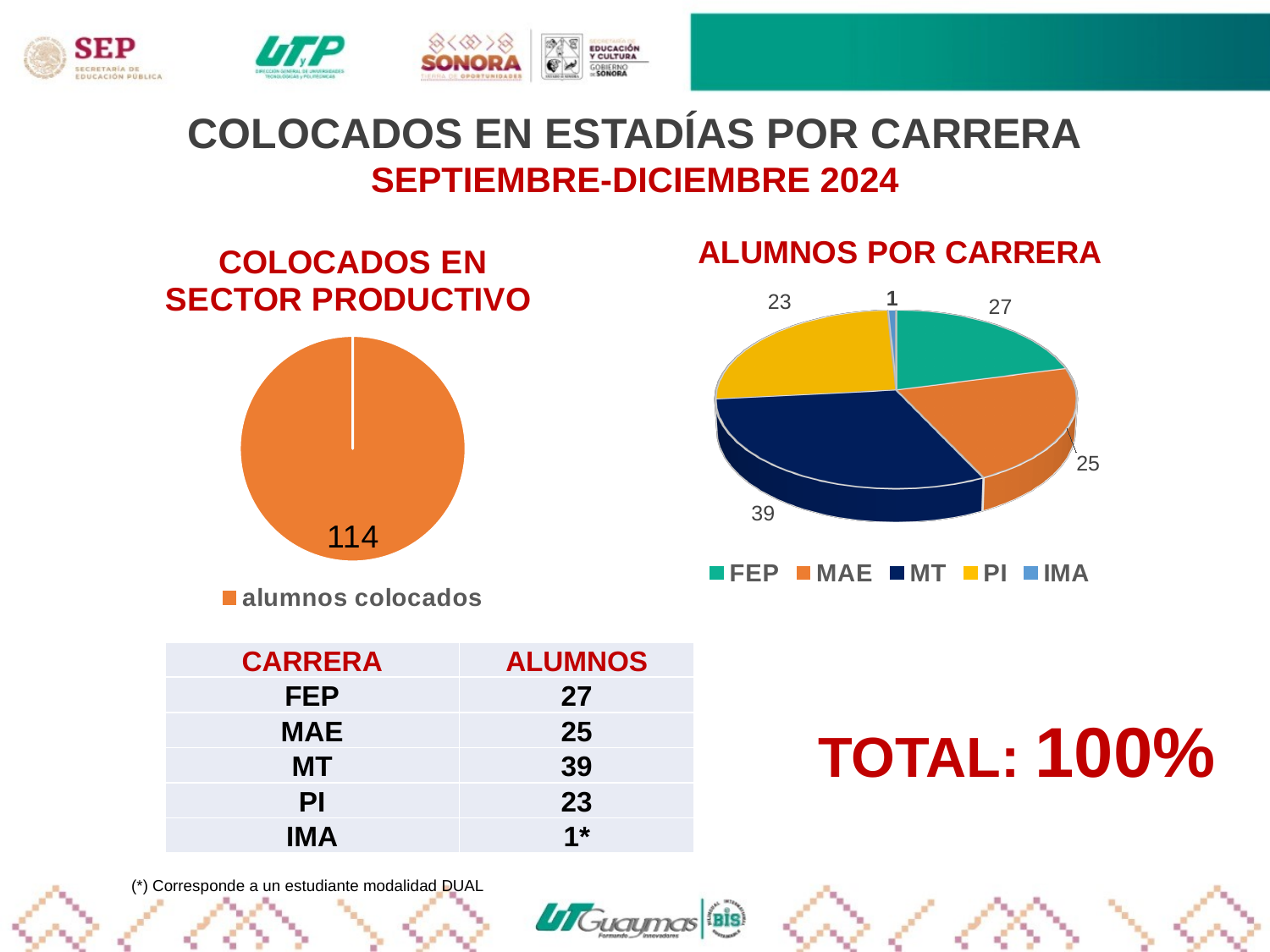
In the 'ALUMNOS POR CARRERA' chart, what is the value for IMA? 1 What kind of chart is 'ALUMNOS POR CARRERA'? Pie chart In the 'COLOCADOS EN SECTOR PRODUCTIVO' chart, what value is shown on the slice? 114 How many categories does the legend of the 'ALUMNOS POR CARRERA' chart list? 5 In the 'ALUMNOS POR CARRERA' chart, what is the difference between the values for MT and FEP? 12 What is the legend entry of the 'COLOCADOS EN SECTOR PRODUCTIVO' chart? alumnos colocados In the 'ALUMNOS POR CARRERA' chart, what colour is the MT slice? Dark blue In the 'ALUMNOS POR CARRERA' chart, what is the value for MT? 39 In the 'ALUMNOS POR CARRERA' chart, what is the value for PI? 23 In the 'ALUMNOS POR CARRERA' chart, which career has the smallest slice? IMA In the 'ALUMNOS POR CARRERA' chart, which is larger, FEP or MAE? FEP In the 'ALUMNOS POR CARRERA' chart, which career has the largest slice? MT